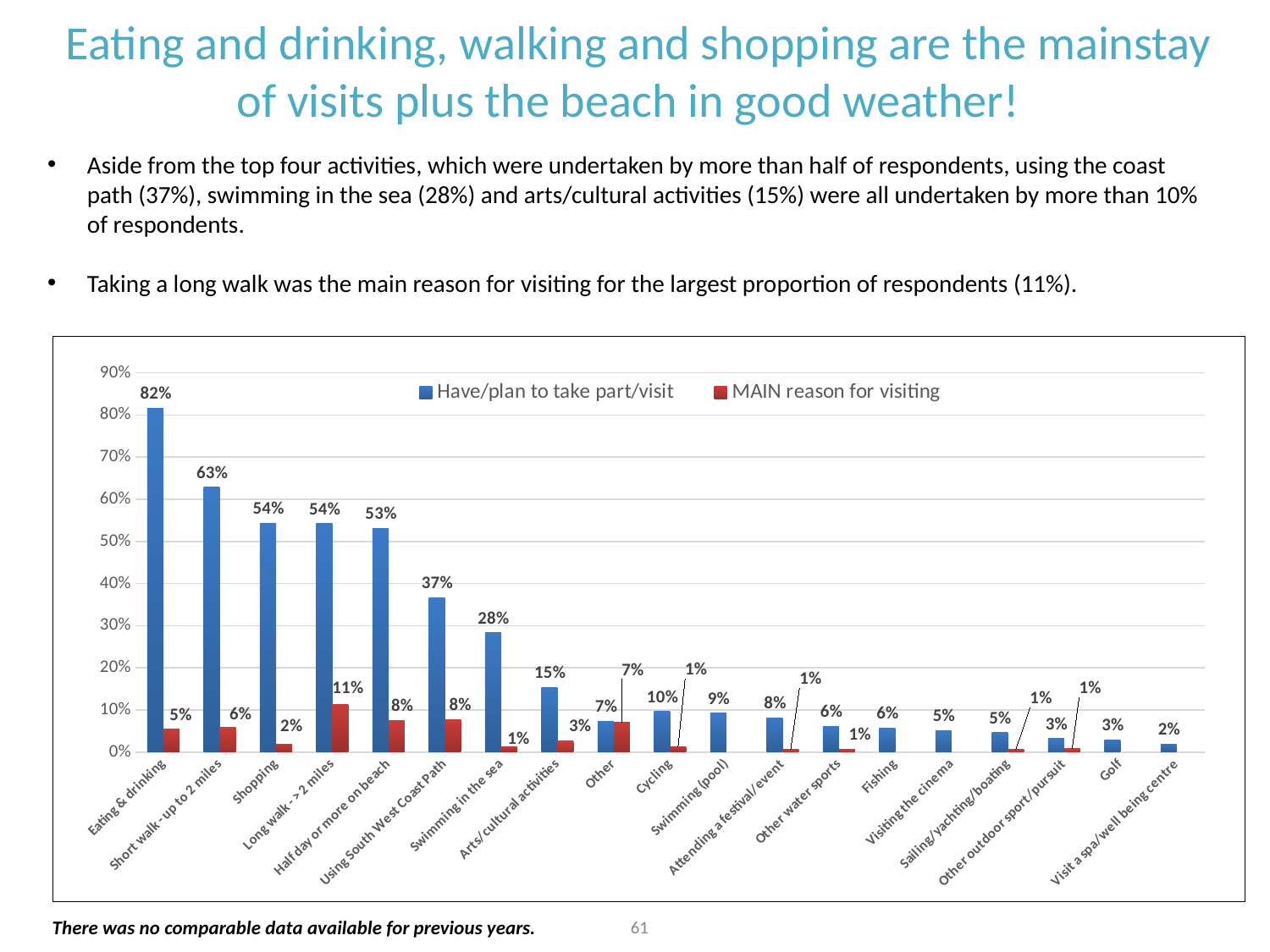
Which has a higher Have/plan to take part/visit value: Using South West Coast Path or Swimming in the sea? Using South West Coast Path What is the MAIN reason for visiting value for Shopping? 2% Which activity has the highest MAIN reason for visiting value? Long walk - > 2 miles What is the MAIN reason for visiting value for Long walk - > 2 miles? 11% What kind of chart is shown on the slide? Bar chart What is the difference in Have/plan to take part/visit between Eating & drinking and Short walk - up to 2 miles? 19 percentage points What colour are the bars for the MAIN reason for visiting series? Red Which activity has the lowest Have/plan to take part/visit value? Visit a spa/well being centre Which activity has the highest Have/plan to take part/visit value? Eating & drinking What percentage of respondents have/plan to take part in Eating & drinking? 82% How many series does the legend list? 2 How many activity categories are shown on the x axis? 19